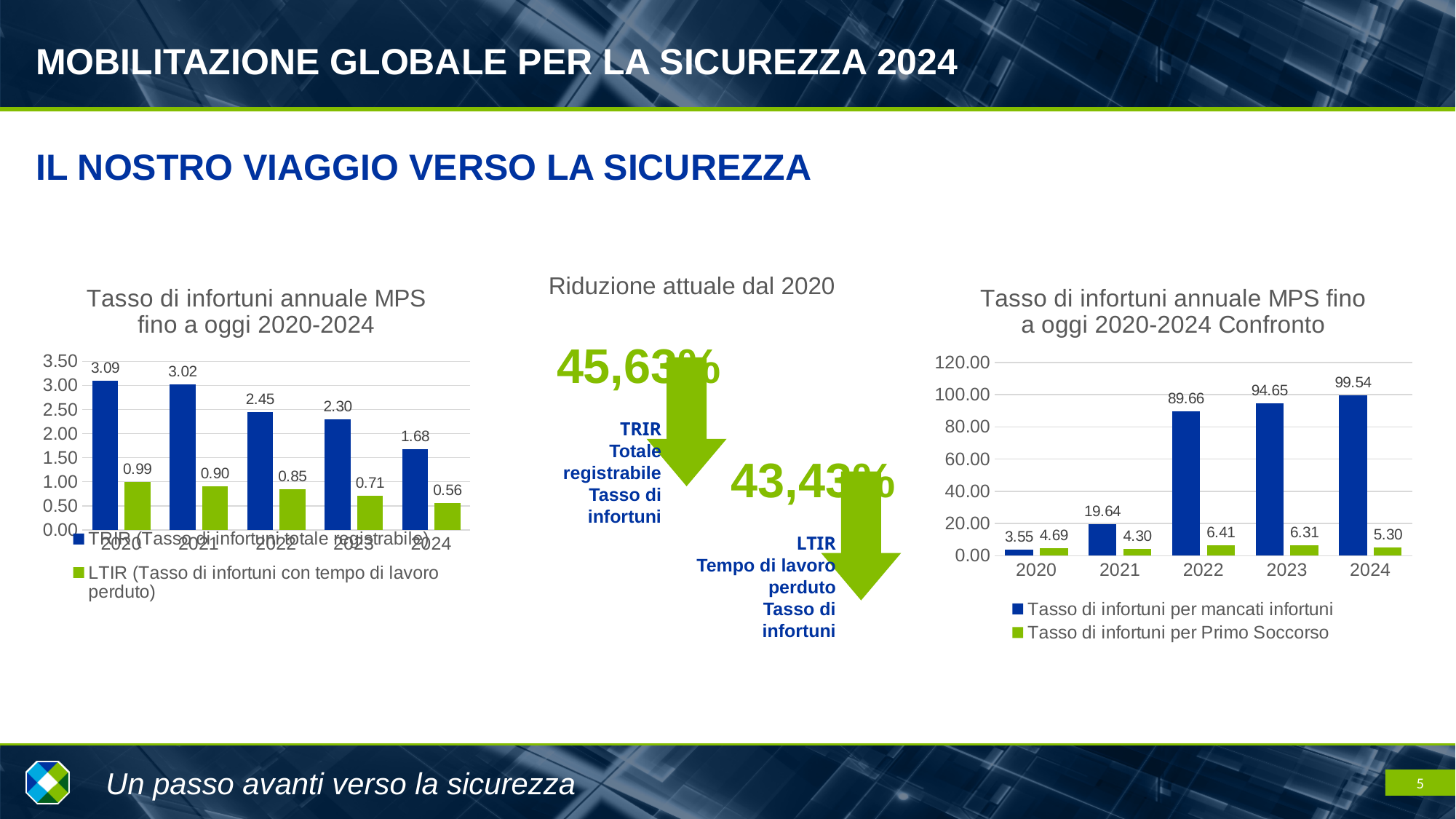
In the left chart 'Tasso di infortuni annuale MPS fino a oggi 2020-2024', what is the TRIR value for 2020? 3.09 In the right chart 'Tasso di infortuni annuale MPS fino a oggi 2020-2024 Confronto', which year has the highest value for 'Tasso di infortuni per Primo Soccorso'? 2022 In the right chart 'Tasso di infortuni annuale MPS fino a oggi 2020-2024 Confronto', which year has the highest value for 'Tasso di infortuni per mancati infortuni'? 2024 What kind of chart is the right chart 'Tasso di infortuni annuale MPS fino a oggi 2020-2024 Confronto'? bar chart In the left chart 'Tasso di infortuni annuale MPS fino a oggi 2020-2024', does the TRIR series rise or fall from 2020 to 2024? fall In the right chart 'Tasso di infortuni annuale MPS fino a oggi 2020-2024 Confronto', which is larger in 2020: 'Tasso di infortuni per mancati infortuni' or 'Tasso di infortuni per Primo Soccorso'? Tasso di infortuni per Primo Soccorso In the left chart 'Tasso di infortuni annuale MPS fino a oggi 2020-2024', how many series does the legend list? 2 In the left chart 'Tasso di infortuni annuale MPS fino a oggi 2020-2024', what is the LTIR value for 2024? 0.56 In the right chart 'Tasso di infortuni annuale MPS fino a oggi 2020-2024 Confronto', what is the value for 'Tasso di infortuni per mancati infortuni' in 2023? 94.65 In the right chart 'Tasso di infortuni annuale MPS fino a oggi 2020-2024 Confronto', how many years are shown on the x axis? 5 In the left chart 'Tasso di infortuni annuale MPS fino a oggi 2020-2024', what is the difference between the TRIR values for 2020 and 2024? 1.41 In the left chart 'Tasso di infortuni annuale MPS fino a oggi 2020-2024', which year has the lowest TRIR value? 2024